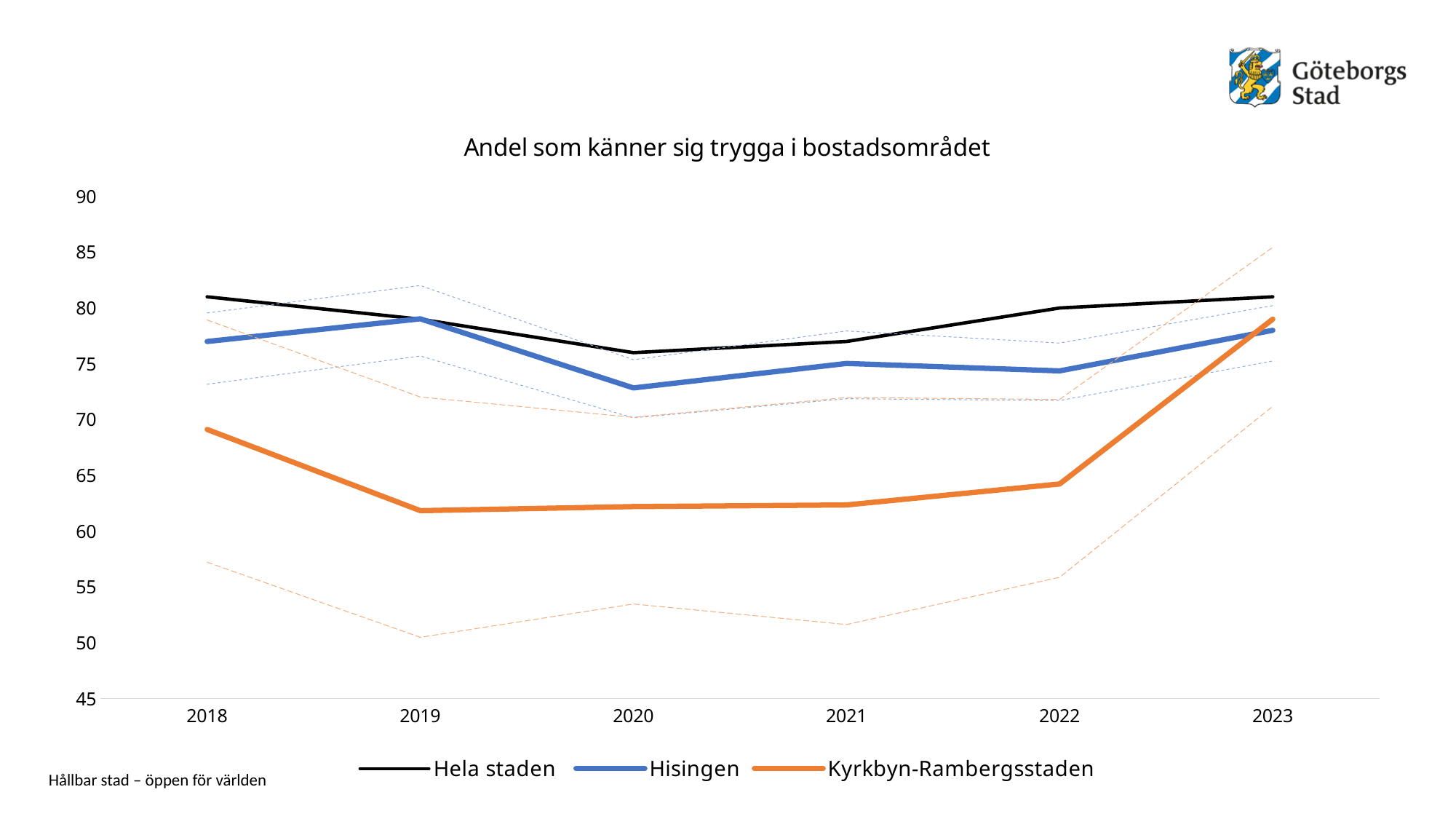
Is the value for Kyrkbyn-Rambergsstaden in 2023 greater or less than 75? greater How many years are shown on the x axis? 6 Does the value for Kyrkbyn-Rambergsstaden rise or fall from 2022 to 2023? rise How many series does the legend list? 3 Which colour is used for the Kyrkbyn-Rambergsstaden line? orange What kind of chart is shown on the slide? line chart Which series has the highest value in 2020? Hela staden Which series has the lowest value in 2019? Kyrkbyn-Rambergsstaden Is the value for Kyrkbyn-Rambergsstaden in 2019 greater or less than 65? less In which year is the value for Kyrkbyn-Rambergsstaden highest? 2023 Which is larger in 2022, the value for Hisingen or the value for Kyrkbyn-Rambergsstaden? Hisingen What is the title of the chart? Andel som känner sig trygga i bostadsområdet